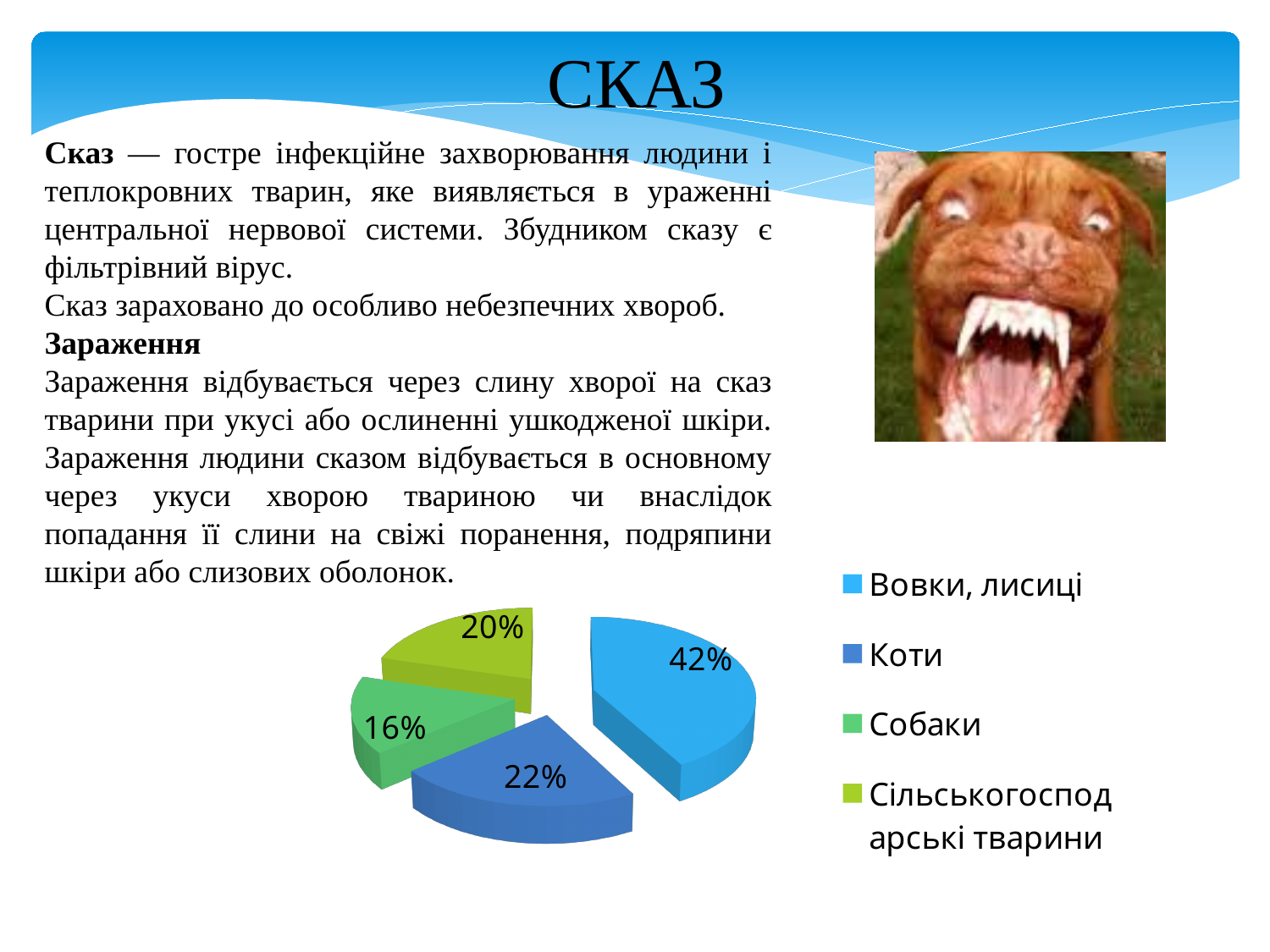
What share of the pie chart is labelled for Сільськогосподарські тварини? 20% Which slice is larger in the pie chart: Сільськогосподарські тварини or Собаки? Сільськогосподарські тварини How many categories does the pie chart legend list? 4 What share of the pie chart is labelled for Собаки? 16% What colour is the Коти slice in the pie chart? Dark blue Which category has the smallest slice in the pie chart? Собаки What share of the pie chart is labelled for Вовки, лисиці? 42% Which category has the largest slice in the pie chart? Вовки, лисиці What is the difference in percentage points between the Сільськогосподарські тварини slice and the Собаки slice? 4 What kind of chart is shown on the slide? Pie chart What is the difference in percentage points between the Вовки, лисиці slice and the Коти slice? 20 What share of the pie chart is labelled for Коти? 22%